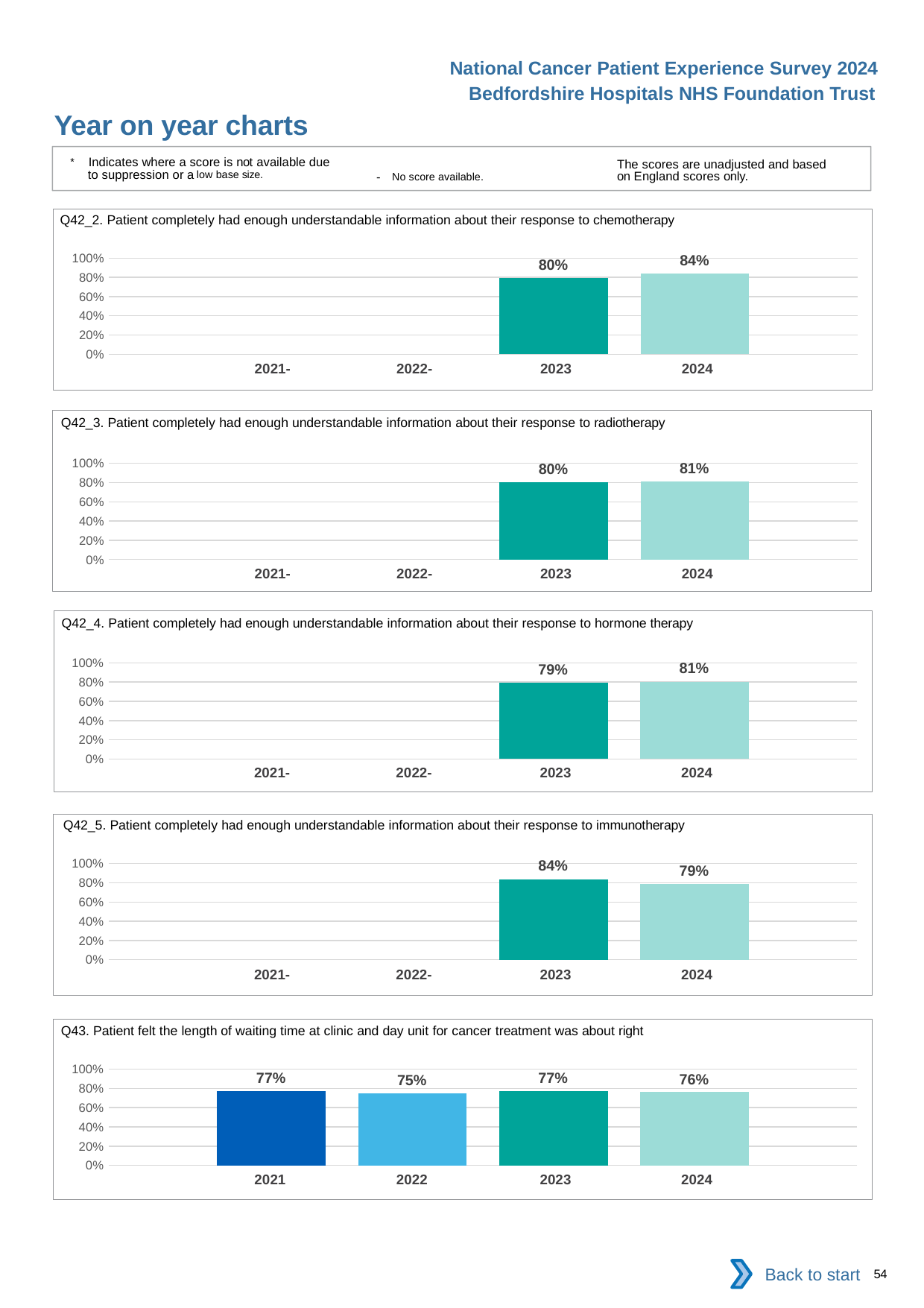
In the Q43 chart (waiting time at clinic and day unit), how many bars are plotted? 4 In the Q42_2 chart (chemotherapy), do the values rise or fall from 2023 to 2024? Rise In the Q42_2 chart (chemotherapy), what is the value for 2024? 84% In the Q43 chart (waiting time at clinic and day unit), what is the value for 2021? 77% In the Q43 chart (waiting time at clinic and day unit), which year has the lowest value? 2022 In the Q42_3 chart (radiotherapy), what is the value for 2023? 80% What type of chart is the Q43 chart? Bar chart In the Q42_2 chart (chemotherapy), how many years have a bar plotted? 2 In the Q42_4 chart (hormone therapy), what is the difference between the 2024 and 2023 values? 2% In the Q43 chart (waiting time at clinic and day unit), what is the difference between the 2021 and 2022 values? 2% In the Q42_5 chart (immunotherapy), which year has the higher value, 2023 or 2024? 2023 In the Q42_5 chart (immunotherapy), what is the value for 2024? 79%